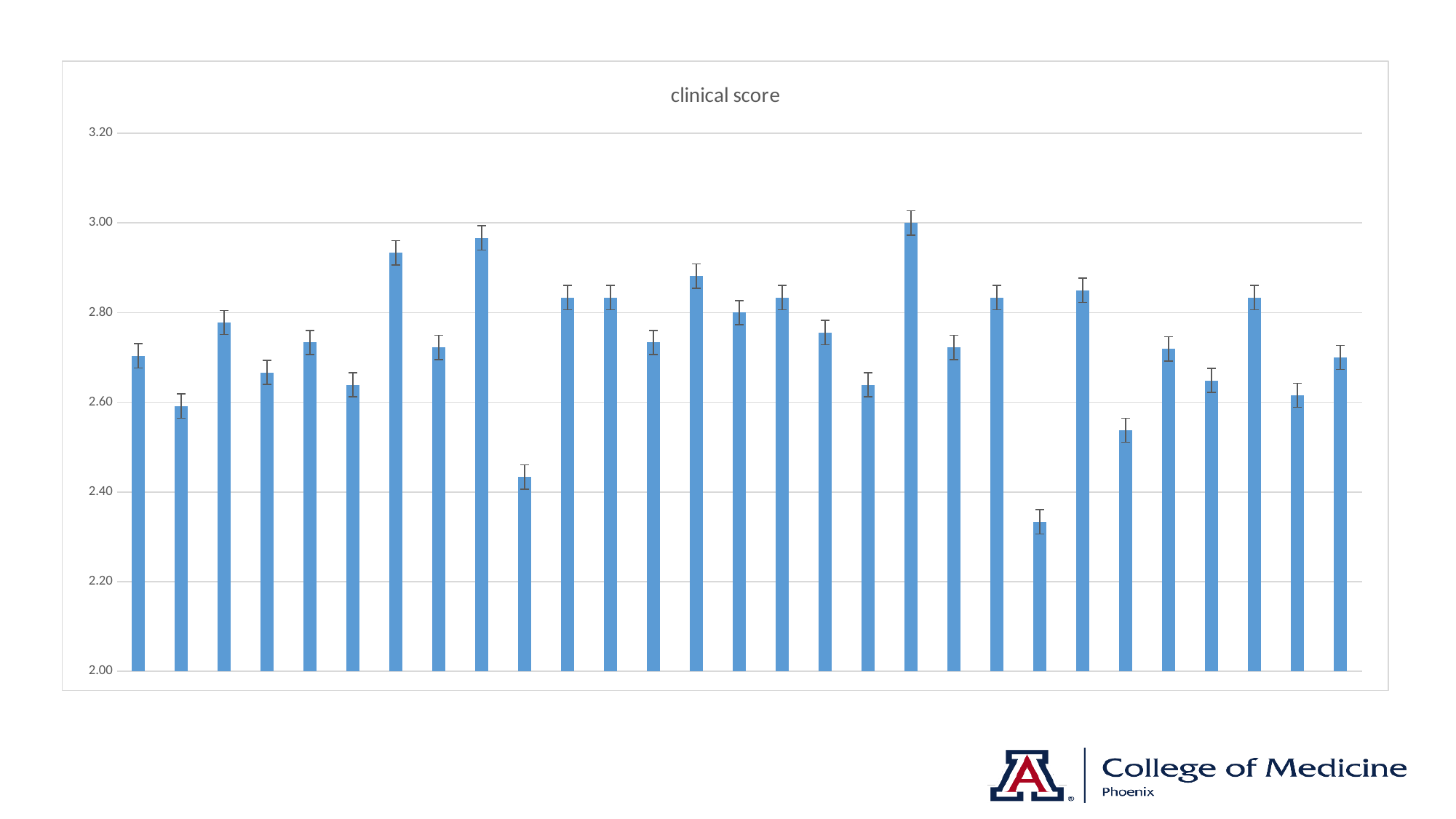
How many bars are plotted in the chart? 29 Counting from the left, which bar is the shortest in the chart? the 22nd bar Is the value of the 10th bar from the left greater or less than 2.60? less What is the title of the chart? clinical score Which is taller, the 22nd bar from the left or the 23rd bar from the left? the 23rd bar What is the lowest value shown on the vertical axis? 2.00 Which is taller, the 9th bar from the left or the 10th bar from the left? the 9th bar Is the value of the 7th bar from the left greater or less than 2.80? greater What kind of chart is shown on the slide? bar chart Is the value of the tallest bar in the chart greater or less than 2.80? greater